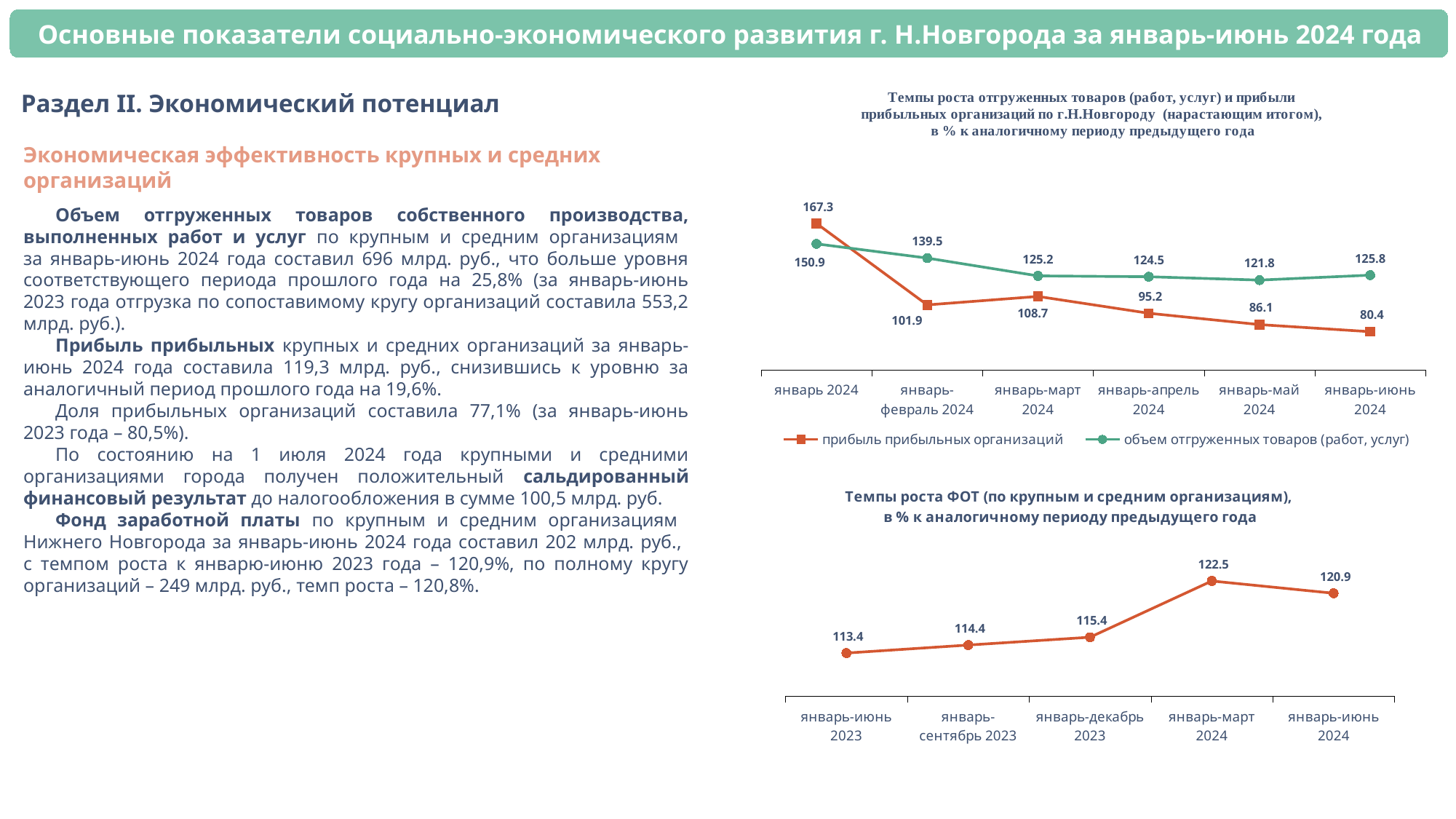
In the top chart (Темпы роста отгруженных товаров и прибыли), does the прибыль прибыльных организаций series generally rise or fall from январь 2024 to январь-июнь 2024? fall In the bottom chart (Темпы роста ФОТ), which period has the highest value? январь-март 2024 In the top chart (Темпы роста отгруженных товаров и прибыли), how many periods are shown on the x axis? 6 In the top chart (Темпы роста отгруженных товаров и прибыли), what is the difference between the объем отгруженных товаров value and the прибыль прибыльных организаций value in январь-май 2024? 35.7 In the top chart (Темпы роста отгруженных товаров и прибыли), what is the value for прибыль прибыльных организаций in январь 2024? 167.3 In the top chart (Темпы роста отгруженных товаров и прибыли), which period has the lowest value for прибыль прибыльных организаций? январь-июнь 2024 What kind of chart is the bottom chart (Темпы роста ФОТ)? line chart In the bottom chart (Темпы роста ФОТ), what is the difference between the values for январь-март 2024 and январь-июнь 2024? 1.6 In the top chart (Темпы роста отгруженных товаров и прибыли), how many series does the legend list? 2 In the bottom chart (Темпы роста ФОТ), what is the value for январь-сентябрь 2023? 114.4 In the top chart (Темпы роста отгруженных товаров и прибыли), which series has the higher value in январь 2024: прибыль прибыльных организаций or объем отгруженных товаров? прибыль прибыльных организаций In the top chart (Темпы роста отгруженных товаров и прибыли), what is the value for объем отгруженных товаров (работ, услуг) in январь-июнь 2024? 125.8